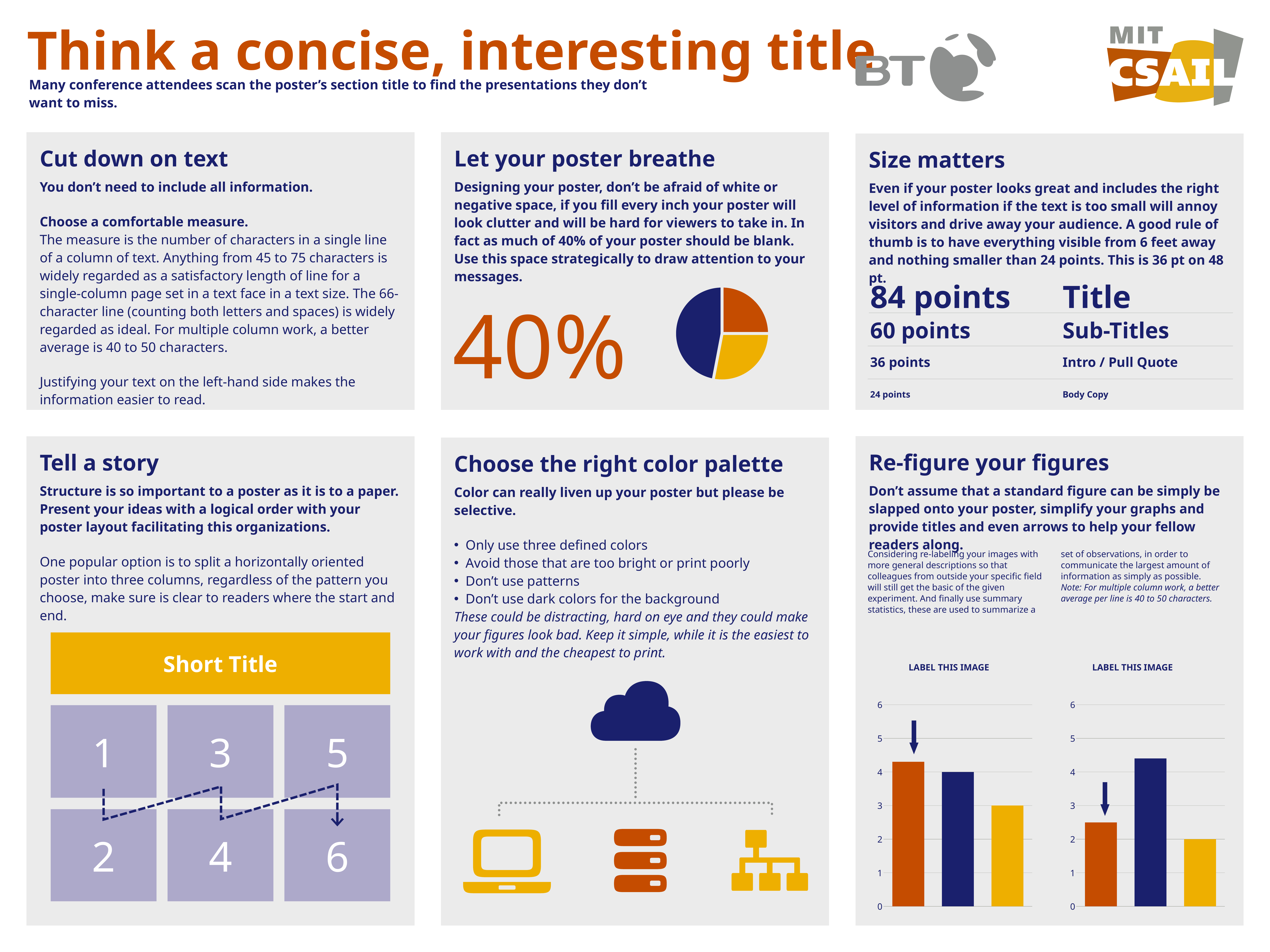
In the left 'LABEL THIS IMAGE' bar chart, what value does the yellow bar reach on the axis? 3 What kind of charts are the two 'LABEL THIS IMAGE' charts in the 'Re-figure your figures' section? bar charts In the left 'LABEL THIS IMAGE' bar chart, which is larger, the navy bar or the yellow bar? the navy bar What kind of chart is shown in the 'Let your poster breathe' section? pie chart In the right 'LABEL THIS IMAGE' bar chart, which colour bar is the highest? navy blue In the left 'LABEL THIS IMAGE' bar chart, how many bars are plotted? 3 In the left 'LABEL THIS IMAGE' bar chart, is the value of the orange bar greater or less than 3? greater In the right 'LABEL THIS IMAGE' bar chart, what value does the yellow bar reach on the axis? 2 In the right 'LABEL THIS IMAGE' bar chart, is the value of the orange bar greater or less than 3? less In the left 'LABEL THIS IMAGE' bar chart, which colour bar is the lowest? yellow How many slices does the pie chart in the 'Let your poster breathe' section have? 3 Which colour slice is the largest in the pie chart in the 'Let your poster breathe' section? navy blue